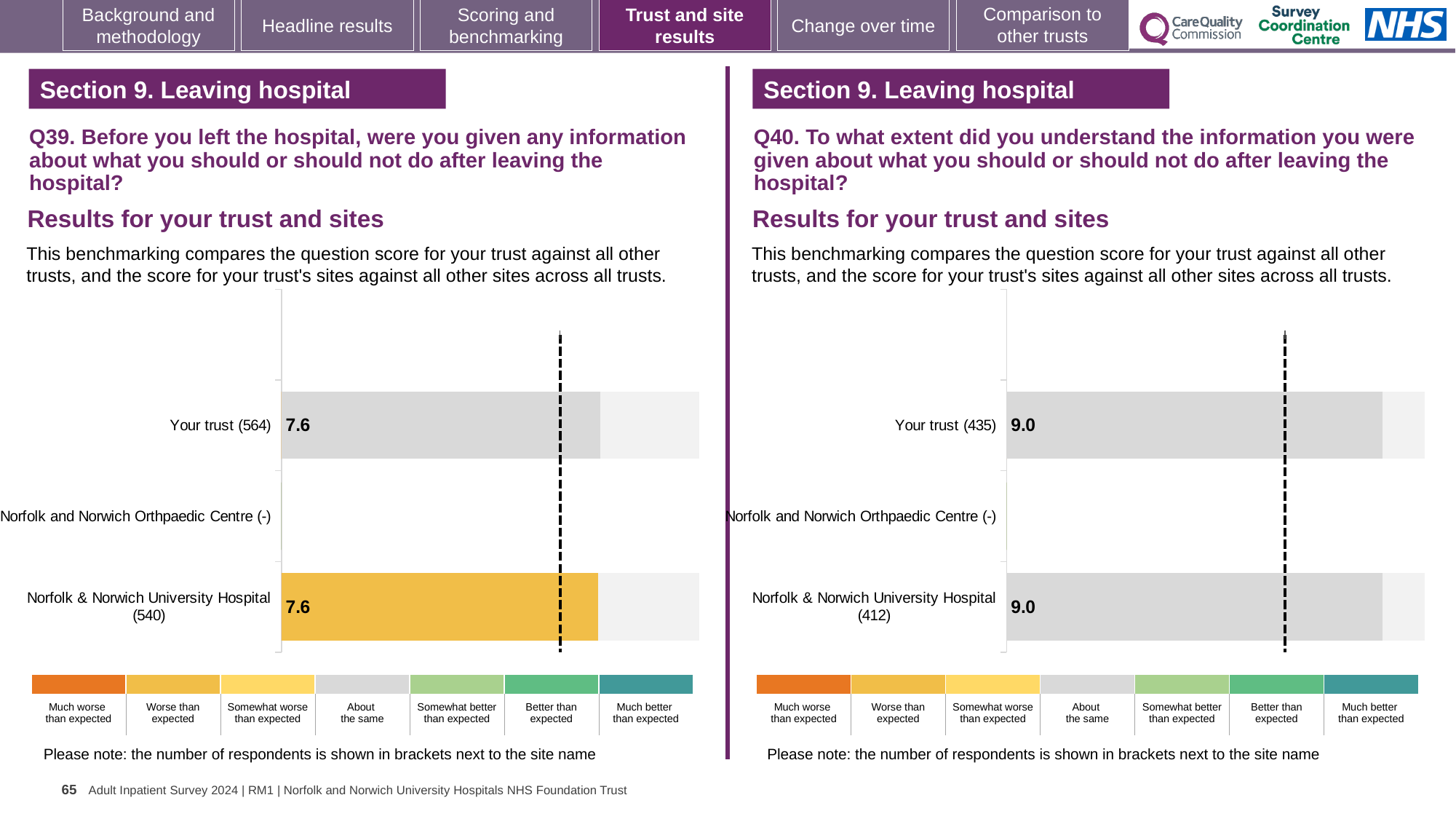
In the Q40 chart on the right, what is the difference between the score for Your trust (435) and the score for Norfolk & Norwich University Hospital (412)? 0.0 In the Q40 chart on the right, what is the score for Norfolk & Norwich University Hospital (412)? 9.0 In the Q39 chart on the left, which category has no bar plotted? Norfolk and Norwich Orthpaedic Centre (-) In the Q40 chart on the right, what is the score for Your trust (435)? 9.0 In the Q40 chart on the right, how many categories are listed on the vertical axis? 3 In the Q39 chart on the left, which benchmark category from the colour key does the colour of the Norfolk & Norwich University Hospital (540) bar correspond to? Worse than expected What kind of chart is the Q39 chart on the left? Bar chart In the Q40 chart on the right, how many respondents are shown in brackets for Norfolk & Norwich University Hospital? 412 In the Q39 chart on the left, how many categories are listed on the vertical axis? 3 In the Q39 chart on the left, what is the score for Your trust (564)? 7.6 In the Q39 chart on the left, what is the difference between the score for Your trust (564) and the score for Norfolk & Norwich University Hospital (540)? 0.0 In the Q39 chart on the left, what is the score for Norfolk & Norwich University Hospital (540)? 7.6